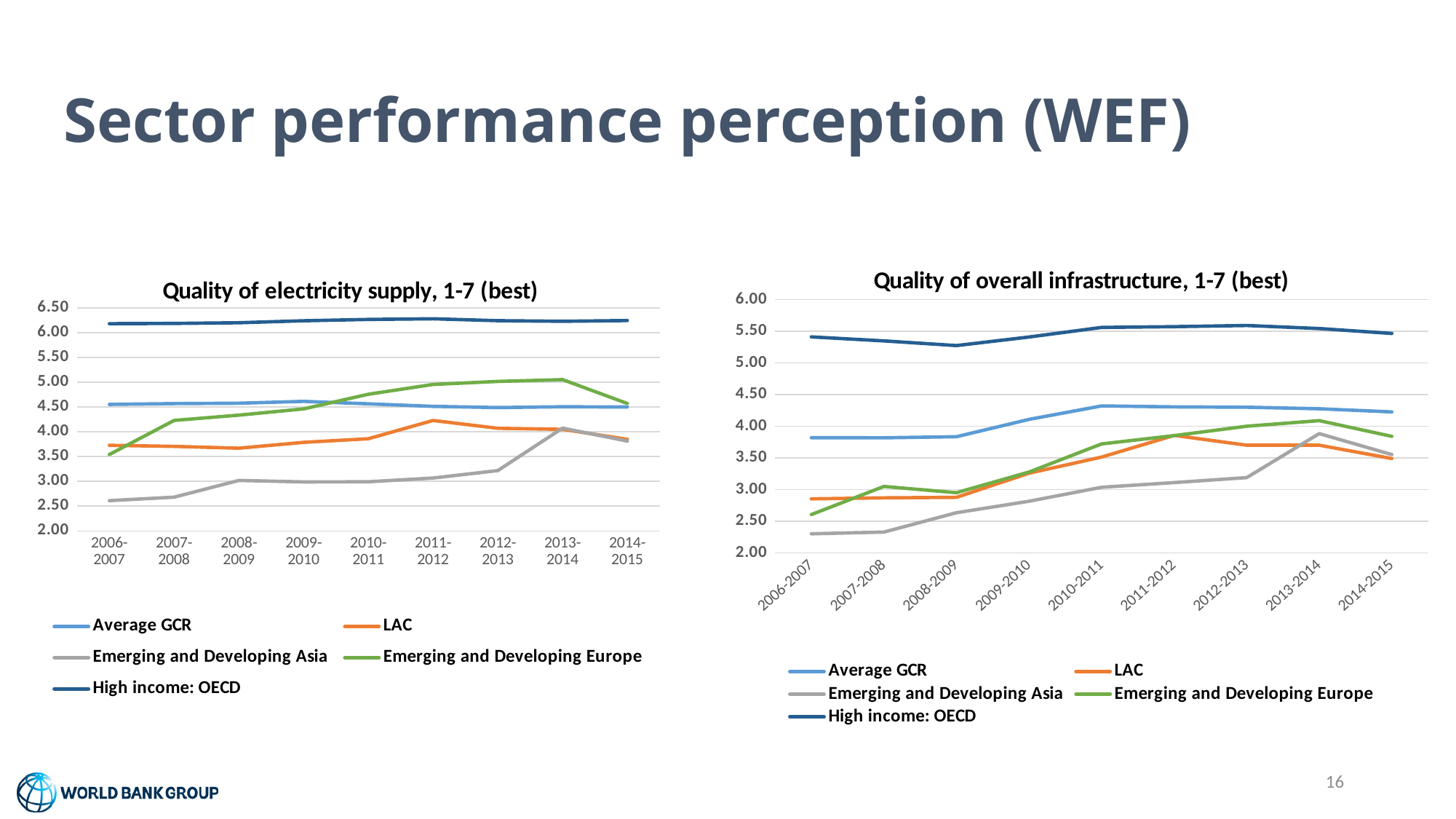
How many periods are shown on the x axis of the 'Quality of overall infrastructure, 1-7 (best)' chart? 9 In the 'Quality of overall infrastructure, 1-7 (best)' chart, is the value for Average GCR in 2010-2011 greater or less than 4.00? greater In the 'Quality of electricity supply, 1-7 (best)' chart, is the value for Emerging and Developing Asia in 2006-2007 greater or less than 3.00? less In the 'Quality of electricity supply, 1-7 (best)' chart, which series has the highest values across all periods? High income: OECD What kind of chart is the 'Quality of electricity supply, 1-7 (best)' chart? line chart In the 'Quality of overall infrastructure, 1-7 (best)' chart, does the Emerging and Developing Asia line rise or fall from 2006-2007 to 2013-2014? rise How many series does the legend of the 'Quality of electricity supply, 1-7 (best)' chart list? 5 In the 'Quality of electricity supply, 1-7 (best)' chart, which is larger in 2012-2013: Emerging and Developing Europe or LAC? Emerging and Developing Europe In the 'Quality of overall infrastructure, 1-7 (best)' chart, is the value for High income: OECD in 2008-2009 greater or less than 5.00? greater What is the title of the chart on the right of the slide? Quality of overall infrastructure, 1-7 (best) In the 'Quality of overall infrastructure, 1-7 (best)' chart, which series has the lowest value in 2006-2007? Emerging and Developing Asia